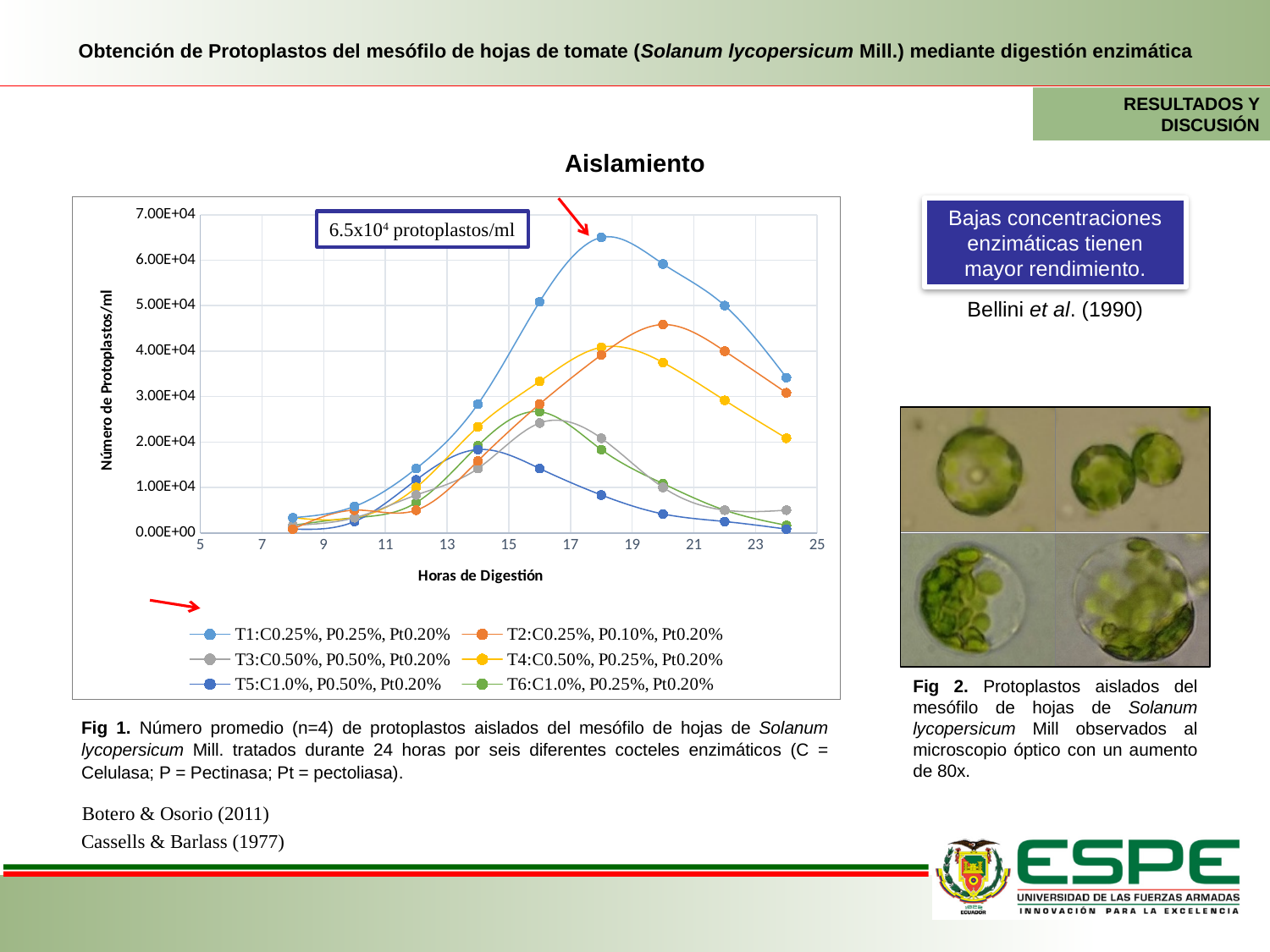
How many series does the legend of the "Aislamiento" chart list? 6 Which series reaches the highest number of protoplasts/ml in the "Aislamiento" chart? T1:C0.25%, P0.25%, Pt0.20% What is the title of the x axis of the "Aislamiento" chart? Horas de Digestión Is the value for T1 at 18 hours of digestion greater or less than 6.00E+04? greater At 24 hours of digestion, which series has the larger value, T2 or T4? T2 Does the T1 series rise or fall between 18 and 24 hours of digestion? fall At 18 hours of digestion, which series has the larger value, T1 or T2? T1 According to the annotation on the chart, what is the peak value reached by the T1 series? 6.5x10⁴ protoplastos/ml What type of chart is shown under the title "Aislamiento"? line chart Is the value for T3 at 16 hours of digestion greater or less than 3.00E+04? less Is the value for T5 at 24 hours of digestion greater or less than 1.00E+04? less